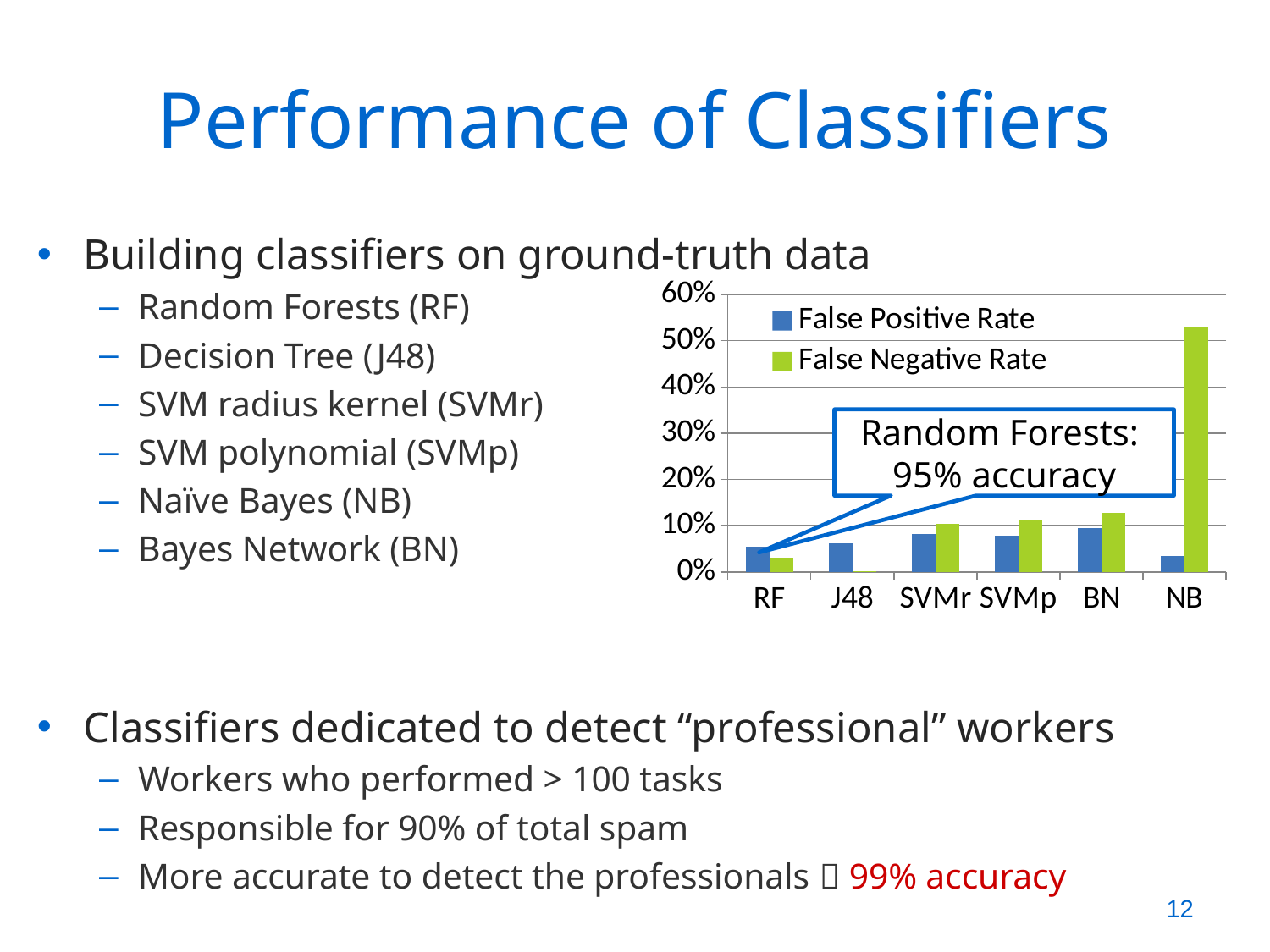
Is the False Positive Rate for RF greater or less than 10%? less Is the False Negative Rate for NB greater or less than 40%? greater Which classifier has the highest False Negative Rate? NB What are the two series named in the chart's legend? False Positive Rate and False Negative Rate Which is larger, the False Negative Rate for NB or the False Negative Rate for RF? NB What kind of chart is shown on the slide? bar chart How many series does the chart's legend list? 2 Is the False Negative Rate for BN greater or less than 20%? less Which classifier has the highest False Positive Rate? BN How many classifiers are shown along the x axis of the chart? 6 For BN, which is larger, the False Positive Rate or the False Negative Rate? False Negative Rate What accuracy does the callout on the chart give for Random Forests? 95% accuracy